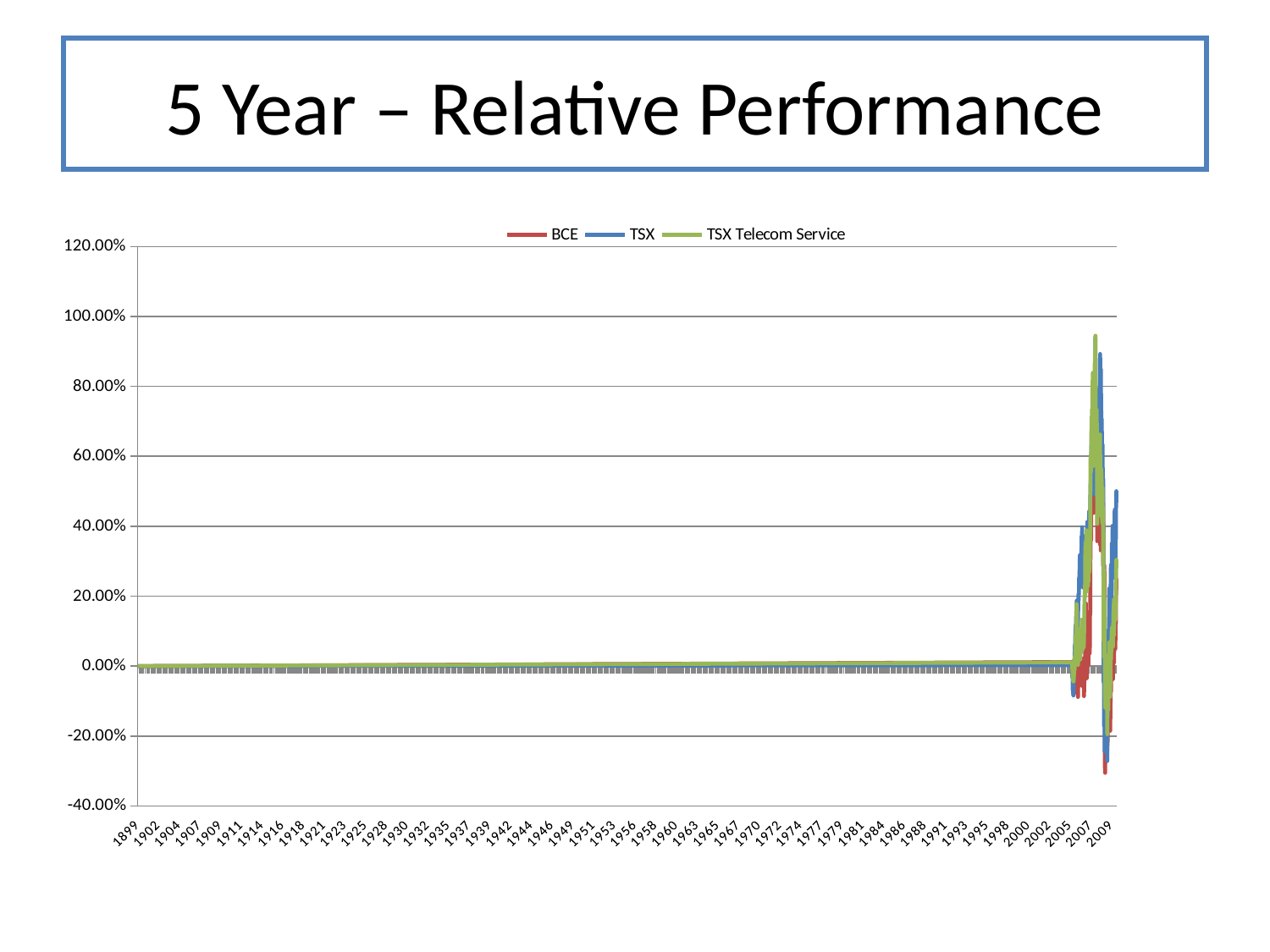
In which part of the x axis do the lines show large swings? Around 2005 to 2009 Is the lowest point of the BCE line greater or less than -20.00%? less Is the value of the TSX line around 1950 greater or less than 20.00%? less Is the value of the BCE line around 1980 greater or less than 40.00%? less How do the three lines behave across most of the x axis before the mid-2000s? They stay flat near 0.00% What kind of chart is shown on the slide? line chart What is the title of the slide containing the chart? 5 Year – Relative Performance Which series is drawn in green in the chart? TSX Telecom Service How many series does the legend list? 3